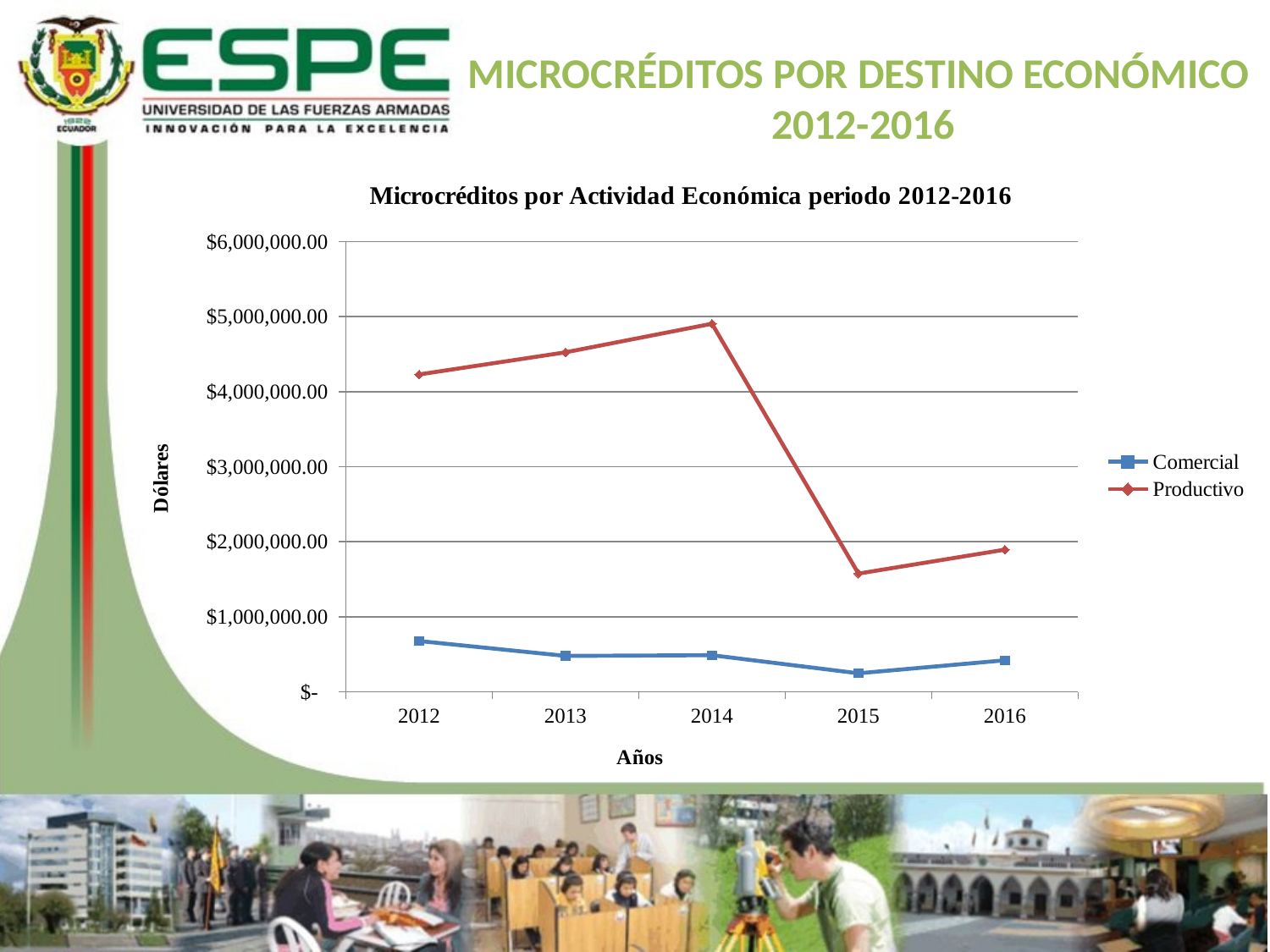
Is the Comercial value for 2012 greater or less than $1,000,000.00? less In which year does the Productivo series reach its lowest value? 2015 How many series does the legend list? 2 How many years are plotted along the x axis? 5 In which year does the Comercial series reach its lowest value? 2015 Is the Productivo value for 2015 greater or less than $2,000,000.00? less Does the Productivo series rise or fall between 2014 and 2015? Fall What is the label of the vertical axis? Dólares Which series has the larger value in 2016, Comercial or Productivo? Productivo Is the Productivo value for 2014 greater or less than $4,000,000.00? greater What kind of chart is shown on the slide? Line chart In which year does the Productivo series reach its highest value? 2014